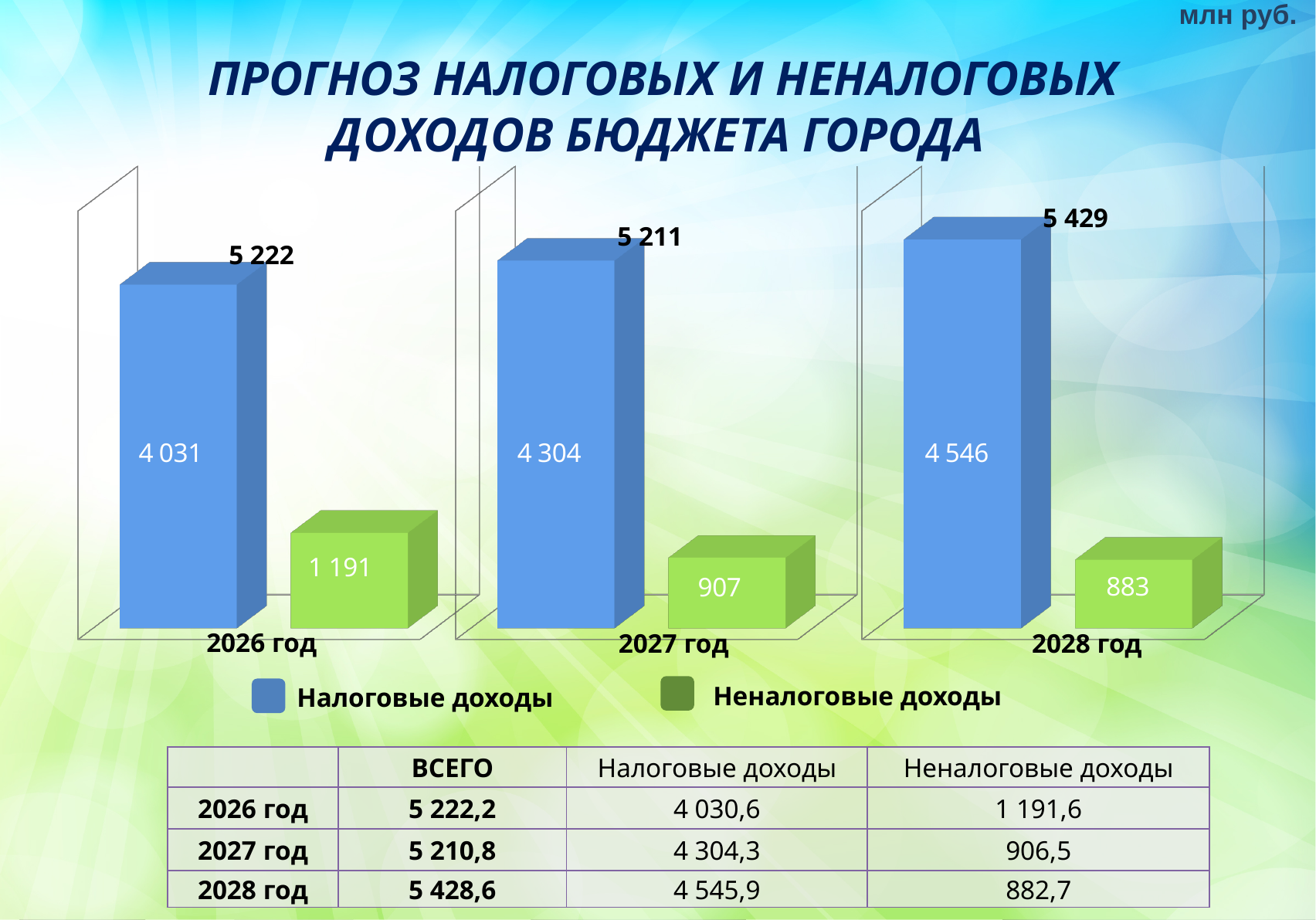
In which year is Неналоговые доходы lowest? 2028 год How many series does the chart legend list? 2 What total is printed above the bars for 2028 год? 5 429 What is the value of Налоговые доходы for 2026 год on the chart? 4 031 How many years are shown on the x axis of the chart? 3 By how much does Налоговые доходы in 2028 год exceed Налоговые доходы in 2026 год? 515 What kind of chart is shown on the slide? Bar chart What is the difference between Налоговые доходы and Неналоговые доходы in 2026 год? 2 840 Do the values for Неналоговые доходы rise or fall from 2026 год to 2028 год? Fall Which is larger: Неналоговые доходы in 2026 год or in 2028 год? 2026 год In which year is Налоговые доходы highest? 2028 год What is the value of Неналоговые доходы for 2027 год on the chart? 907